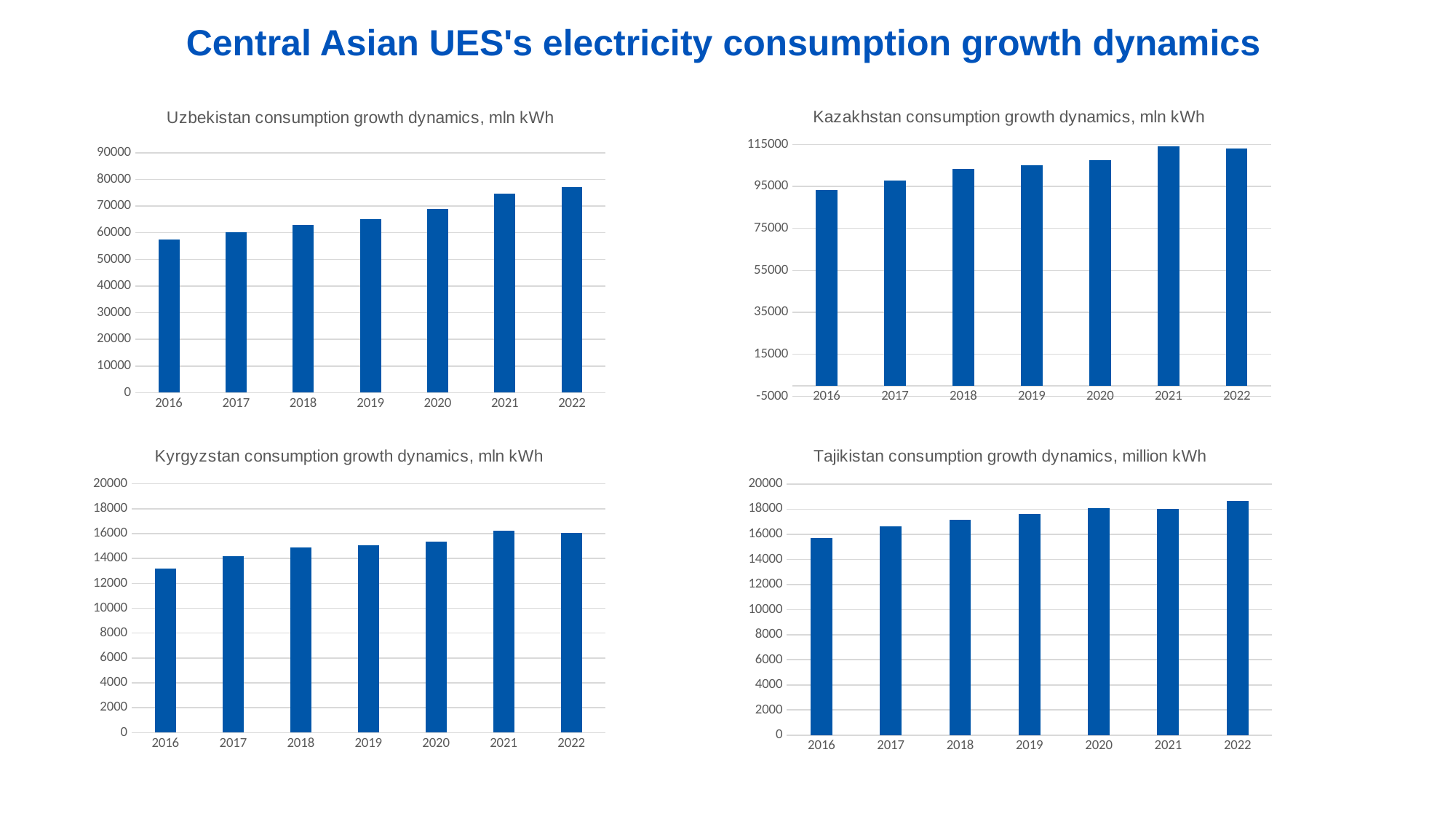
In the Uzbekistan consumption growth dynamics chart, which is larger, the value for 2019 or the value for 2021? 2021 In the Tajikistan consumption growth dynamics chart, which year has the highest value? 2022 How many years are shown on the Kazakhstan consumption growth dynamics chart? 7 In the Tajikistan consumption growth dynamics chart, is the value for 2022 greater or less than 18000? greater In the Uzbekistan consumption growth dynamics chart, is the value for 2016 greater or less than 60000? less In the Uzbekistan consumption growth dynamics chart, which year has the lowest value? 2016 In the Kazakhstan consumption growth dynamics chart, is the value for 2018 greater or less than 95000? greater In the Uzbekistan consumption growth dynamics chart, which year has the highest value? 2022 In the Kazakhstan consumption growth dynamics chart, which year has the lowest value? 2016 What type of chart is the Uzbekistan consumption growth dynamics chart? bar chart In the Kyrgyzstan consumption growth dynamics chart, which year has the lowest value? 2016 In the Uzbekistan consumption growth dynamics chart, do the values generally rise or fall from 2016 to 2022? rise